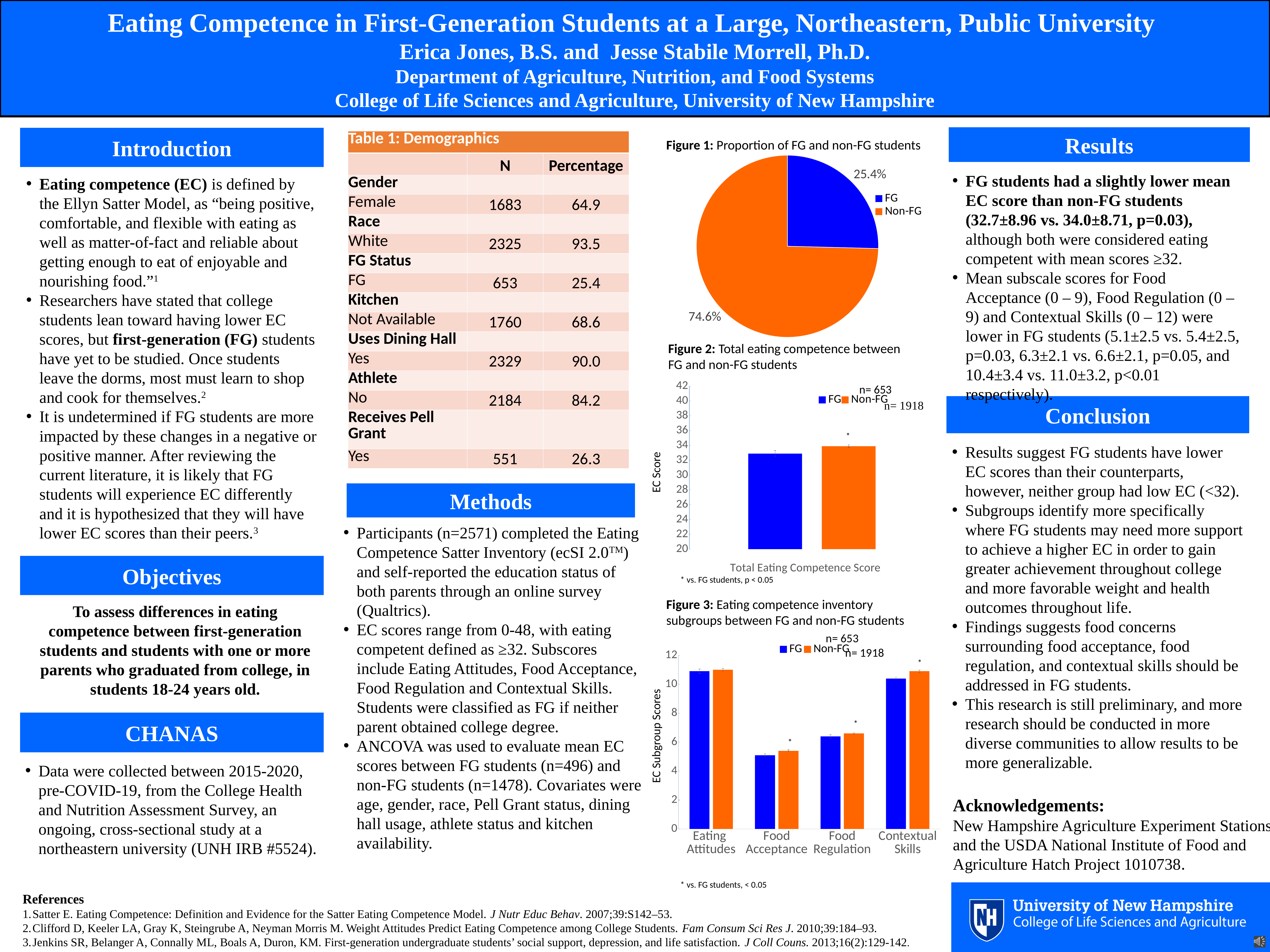
In Figure 1, what share of the pie is labelled FG? 25.4% In Figure 2, is the EC Score for FG greater or less than 34? less How many series does the legend in Figure 3 list? 2 In Figure 1, what share of the pie is labelled Non-FG? 74.6% In Figure 2, which group has the higher EC Score bar, FG or Non-FG? Non-FG What kind of chart is Figure 2? bar chart How many subgroup categories are shown on the x axis of Figure 3? 4 How many slices does the pie in Figure 1 have? 2 In Figure 3, which subgroup has the lowest scores for both FG and Non-FG? Food Acceptance In Figure 1, which slice is larger, FG or Non-FG? Non-FG In Figure 3, is the Food Acceptance score for FG greater or less than 6? less What kind of chart is Figure 1? pie chart